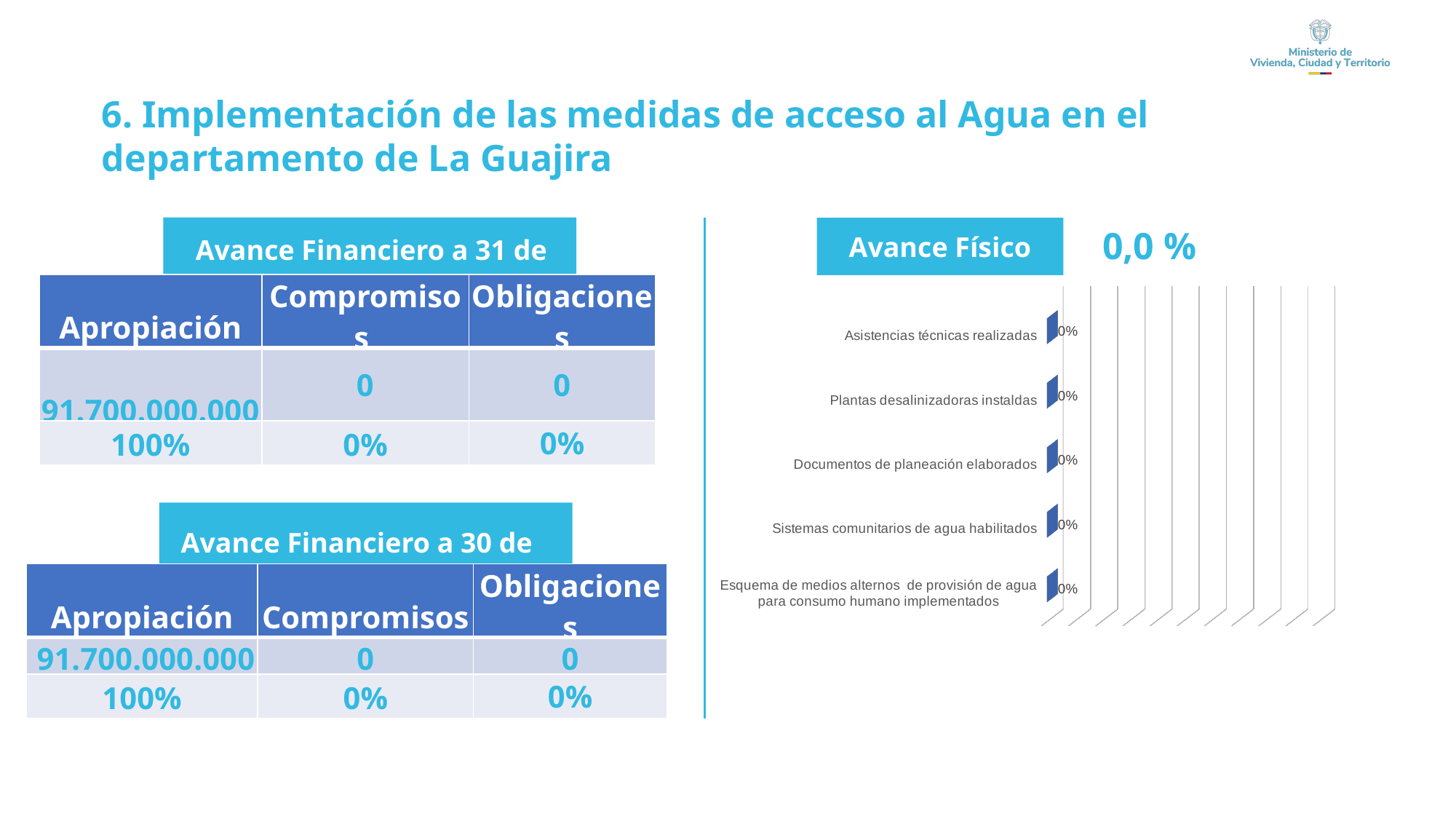
In the "Avance Físico" chart, what is the value for "Esquema de medios alternos de provisión de agua para consumo humano implementados"? 0% How many categories are plotted in the "Avance Físico" bar chart? 5 What overall percentage is printed next to the "Avance Físico" heading? 0,0 % In the "Avance Físico" chart, what is the difference between the values for "Asistencias técnicas realizadas" and "Plantas desalinizadoras instaldas"? 0% What kind of chart is shown under the heading "Avance Físico"? bar chart In the "Avance Físico" chart, what is the value for "Asistencias técnicas realizadas"? 0% Do the values in the "Avance Físico" chart rise, fall, or stay the same across the categories? stay the same In the "Avance Físico" chart, what is the value for "Plantas desalinizadoras instaldas"? 0% In the "Avance Físico" chart, what is the value for "Sistemas comunitarios de agua habilitados"? 0% Are the bars in the "Avance Físico" chart horizontal or vertical? horizontal In the "Avance Físico" chart, what is the value for "Documentos de planeación elaborados"? 0%